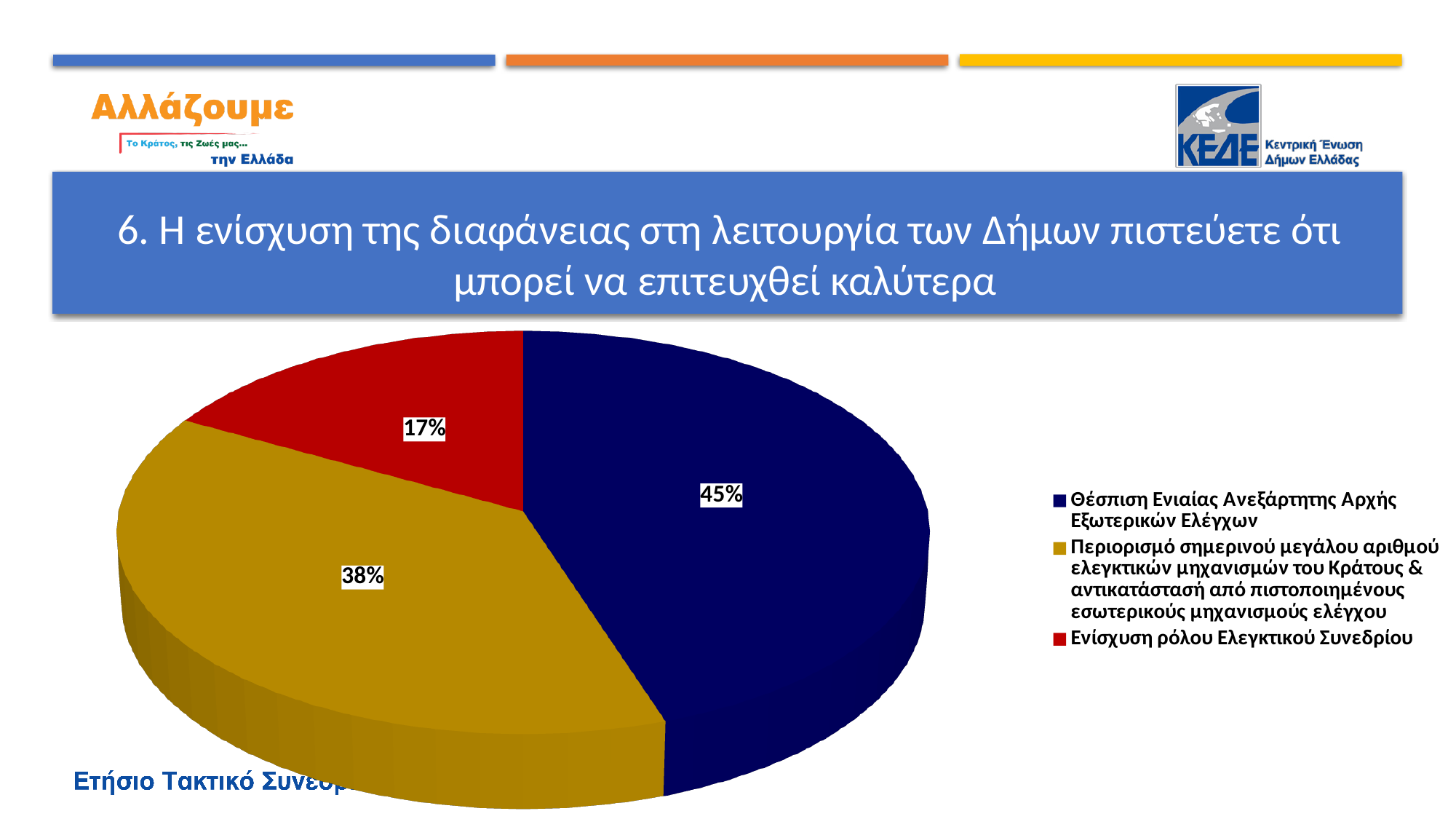
What type of chart is shown on the slide? Pie chart What percentage is shown for 'Περιορισμό σημερινού μεγάλου αριθμού ελεγκτικών μηχανισμών του Κράτους & αντικατάστασή από πιστοποιημένους εσωτερικούς μηχανισμούς ελέγχου'? 38% Which category has the largest share of the pie? Θέσπιση Ενιαίας Ανεξάρτητης Αρχής Εξωτερικών Ελέγχων What colour is the slice for 'Ενίσχυση ρόλου Ελεγκτικού Συνεδρίου'? Red What percentage is shown for 'Ενίσχυση ρόλου Ελεγκτικού Συνεδρίου'? 17% Which is larger: the share for 'Θέσπιση Ενιαίας Ανεξάρτητης Αρχής Εξωτερικών Ελέγχων' or the share for 'Ενίσχυση ρόλου Ελεγκτικού Συνεδρίου'? Θέσπιση Ενιαίας Ανεξάρτητης Αρχής Εξωτερικών Ελέγχων How many entries does the legend list? 3 What is the difference in percentage points between the largest slice (45%) and the smallest slice (17%)? 28 How many slices does the pie chart have? 3 What colour is the slice labelled 38%? Gold What percentage is shown for 'Θέσπιση Ενιαίας Ανεξάρτητης Αρχής Εξωτερικών Ελέγχων'? 45% Which category has the smallest share of the pie? Ενίσχυση ρόλου Ελεγκτικού Συνεδρίου